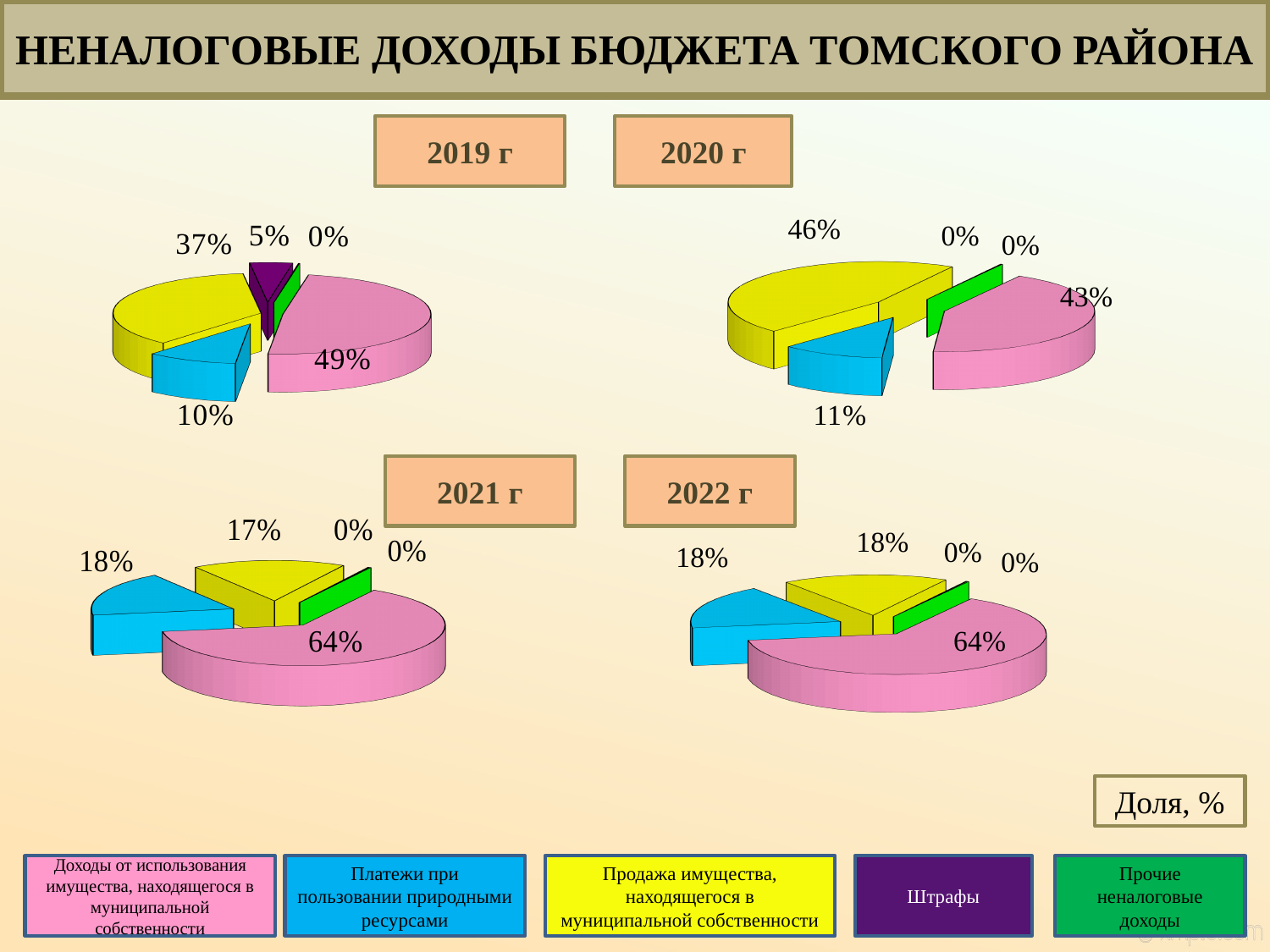
In the 2019 pie chart, what share is shown for income from the use of municipally owned property (pink slice)? 49% What type of chart is used for each year on the slide? Pie chart How many categories does the legend at the bottom of the slide list? 5 In the 2019 pie chart, what share is shown for fines (Штрафы, purple slice)? 5% In the 2020 pie chart, what share is shown for sale of municipally owned property (yellow slice)? 46% How many pie charts are shown on the slide? 4 In the 2022 pie chart, what share is shown for income from the use of municipally owned property (pink slice)? 64% In the 2019 pie chart, what is the difference between the share for income from the use of municipally owned property and the share for sale of municipally owned property? 12% In the 2021 pie chart, what is the difference between the share for payments for the use of natural resources and the share for sale of municipally owned property? 1% In the 2020 pie chart, what share is shown for payments for the use of natural resources (blue slice)? 11% In the 2020 pie chart, which is larger: the share for sale of municipally owned property or the share for income from the use of municipally owned property? Продажа имущества, находящегося в муниципальной собственности In the 2021 pie chart, which category has the largest share? Доходы от использования имущества, находящегося в муниципальной собственности